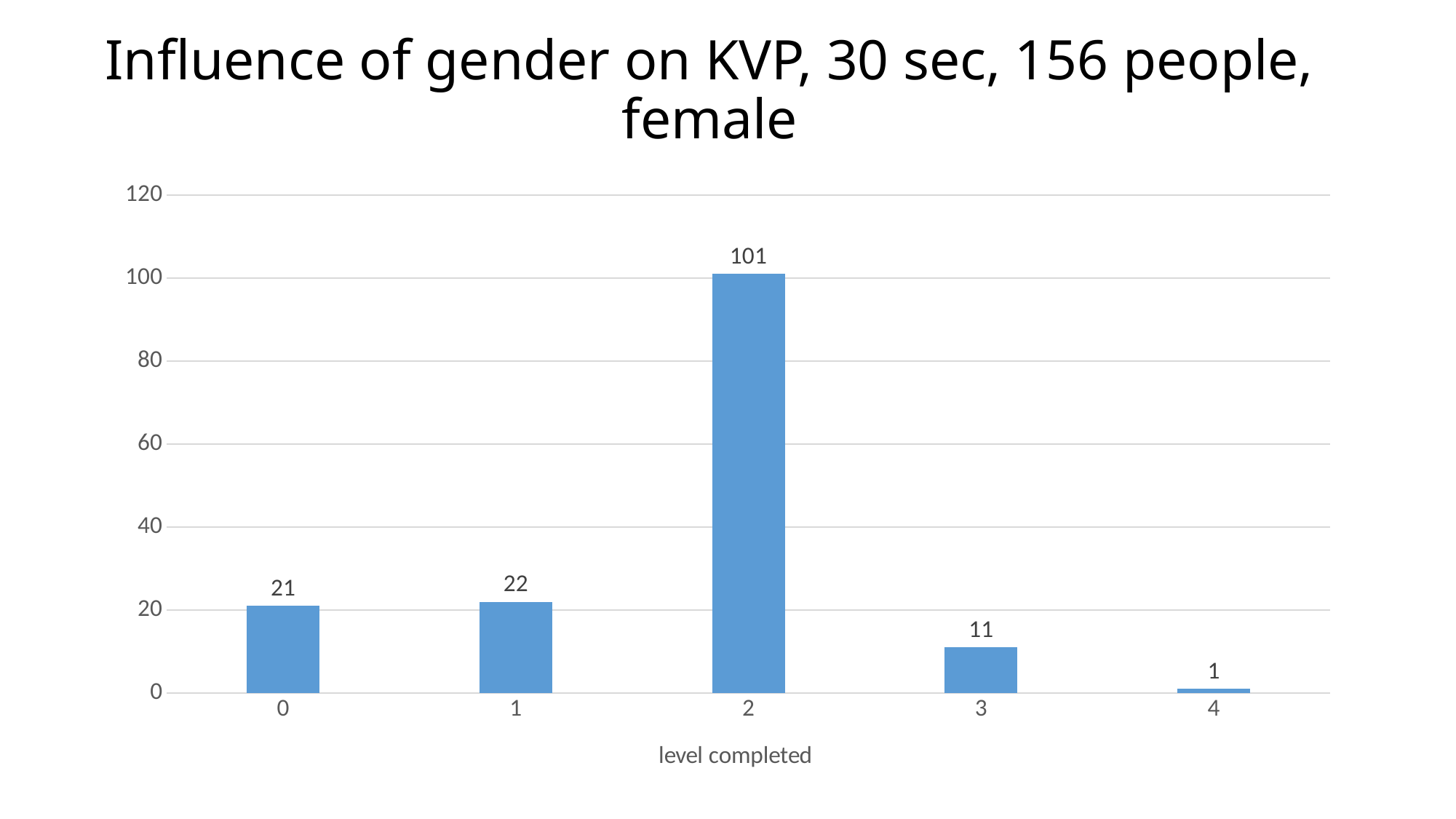
What is the value for level completed 2? 101 Which level completed has the lowest value? 4 What is the difference between the values for level completed 2 and level completed 1? 79 Which level completed has the highest value? 2 How many categories are shown on the x axis? 5 What is the value for level completed 0? 21 What is the x-axis label of the chart? level completed Which is larger, the value for level completed 1 or level completed 3? level completed 1 Is the value for level completed 2 greater or less than 100? greater What kind of chart is shown on the slide? bar chart What is the difference between the values for level completed 3 and level completed 4? 10 What is the value for level completed 4? 1